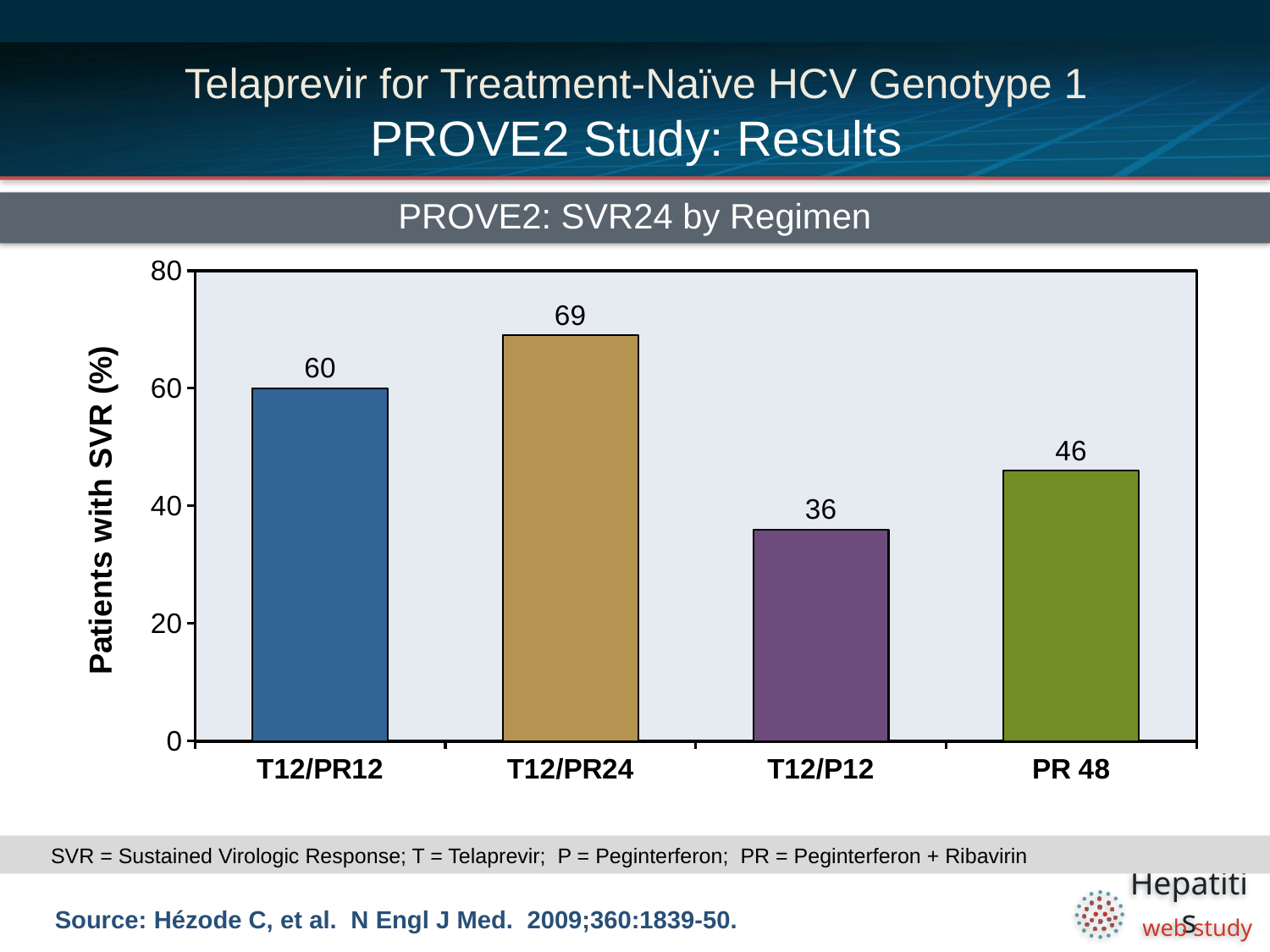
What is the difference in SVR rate between T12/PR12 and T12/P12? 24 What type of chart is shown on the slide? bar chart What is the SVR rate for the T12/PR24 regimen? 69 What is the SVR rate for the T12/P12 regimen? 36 Which regimen has a higher SVR rate, T12/PR12 or PR 48? T12/PR12 What is the label of the y-axis? Patients with SVR (%) How many regimens are shown in the chart? 4 Which regimen has the lowest SVR rate? T12/P12 What is the difference in SVR rate between T12/PR24 and PR 48? 23 Is the SVR rate for T12/P12 greater or less than 40? less Which regimen has the highest SVR rate? T12/PR24 What is the SVR rate for the PR 48 regimen? 46